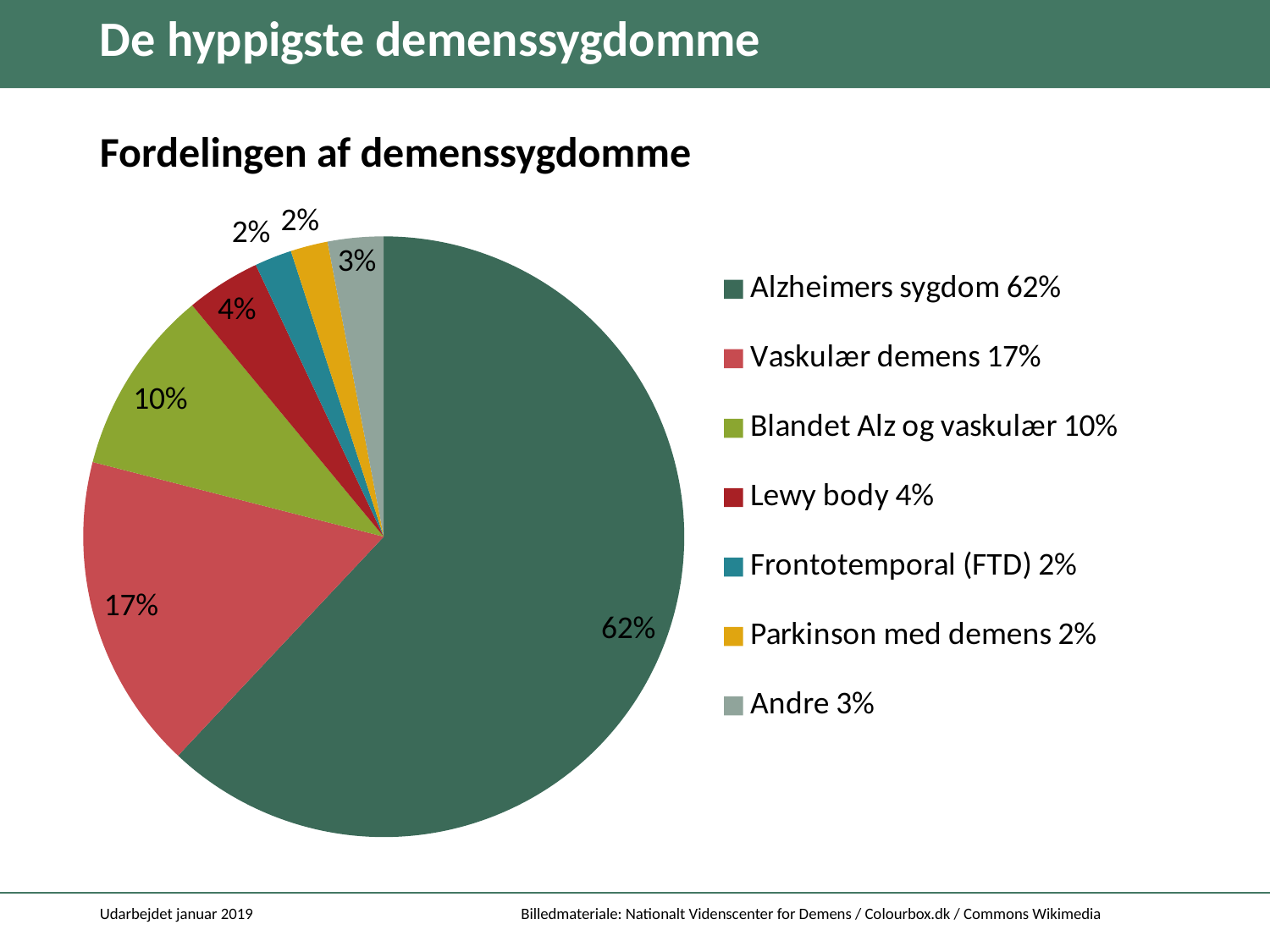
How many categories does the pie chart have? 7 Which is larger, the value for Blandet Alz og vaskulær or the value for Lewy body? Blandet Alz og vaskulær What is the value for Blandet Alz og vaskulær? 10% What is the difference between the values for Vaskulær demens and Blandet Alz og vaskulær? 7% What is the value for Andre? 3% Which category has the largest slice of the pie? Alzheimers sygdom What share of the pie does Alzheimers sygdom have? 62% What is the value for Lewy body? 4% What is the difference between the values for Alzheimers sygdom and Vaskulær demens? 45% What is the value for Vaskulær demens? 17% What kind of chart is shown on the slide? pie chart What is the title of the chart? Fordelingen af demenssygdomme